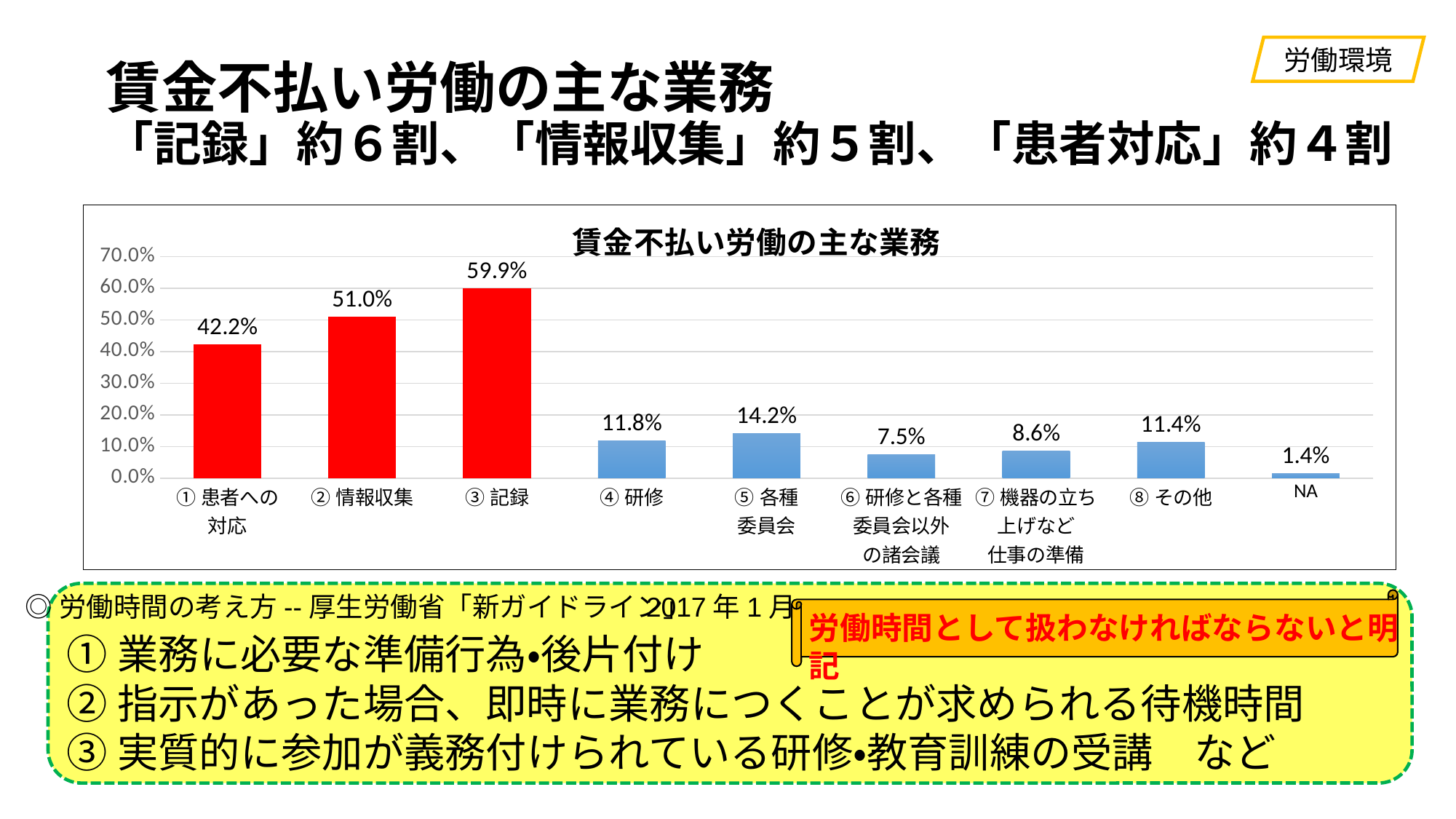
Which category has the lowest value? NA What kind of chart is shown? bar chart What is the value for ⑦ 機器の立ち上げなど仕事の準備? 8.6% Which category has the highest value? ③ 記録 What is the value for ③ 記録? 59.9% How many categories are shown on the x axis? 9 What is the value for ② 情報収集? 51.0% What is the difference between the values for ③ 記録 and ① 患者への対応? 17.7% Is the value for ② 情報収集 greater or less than 50.0%? greater How many bars are coloured red? 3 What is the title of the chart? 賃金不払い労働の主な業務 Which is larger, the value for ④ 研修 or the value for ⑤ 各種委員会? ⑤ 各種委員会